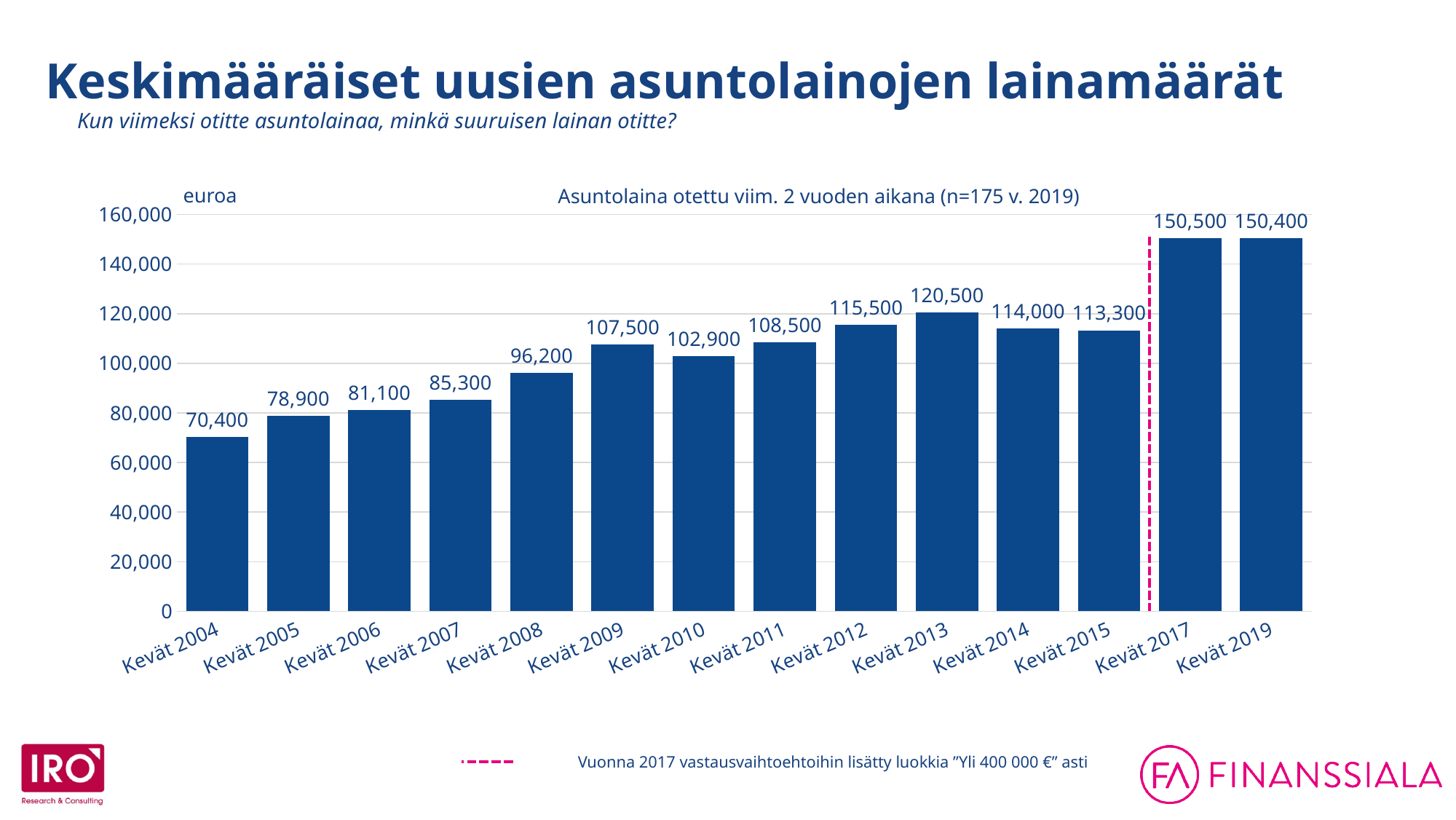
Do the values generally rise or fall from Kevät 2004 to Kevät 2009? rise What unit is shown at the top of the y axis? euroa How many categories are shown on the x axis? 14 What is the value for Kevät 2019? 150,400 Which category has the lowest value? Kevät 2004 What kind of chart is shown on the slide? bar chart Is the value for Kevät 2008 greater or less than 100,000? less Which category has the highest value? Kevät 2017 What is the value for Kevät 2004? 70,400 What is the value for Kevät 2013? 120,500 What is the difference between the values for Kevät 2017 and Kevät 2015? 37,200 Which is larger, the value for Kevät 2009 or the value for Kevät 2010? Kevät 2009